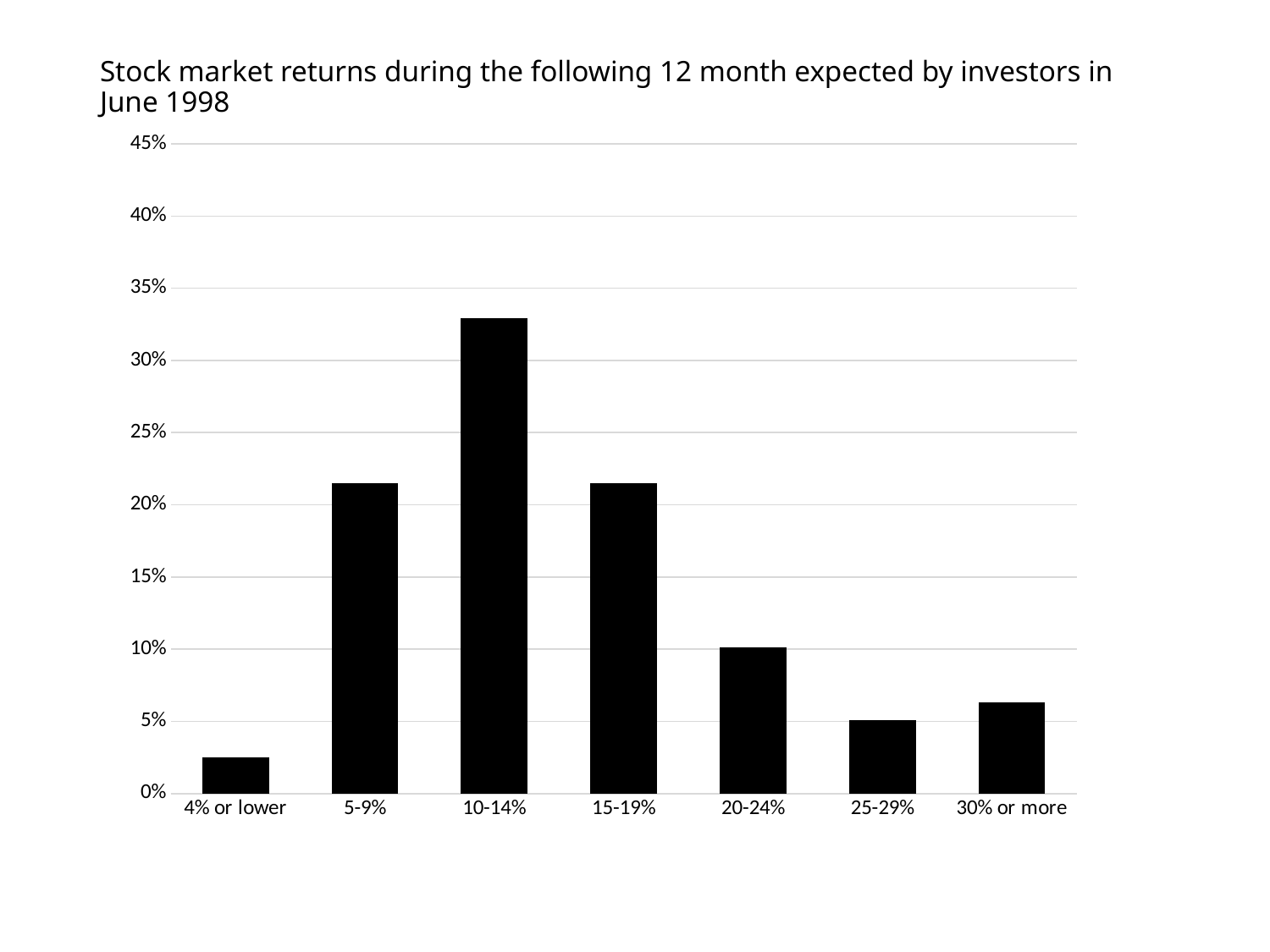
What kind of chart is shown on the slide? bar chart How many categories are shown on the x axis? 7 Which category has the highest value? 10-14% Do the values rise or fall from 10-14% to 25-29%? fall Is the value for 20-24% greater or less than 15%? less Which category has the lowest value? 4% or lower Is the value for 5-9% greater or less than 20%? greater Which is larger, the value for 20-24% or the value for 30% or more? 20-24% Is the value for 4% or lower greater or less than 5%? less What is the title of the chart? Stock market returns during the following 12 month expected by investors in June 1998